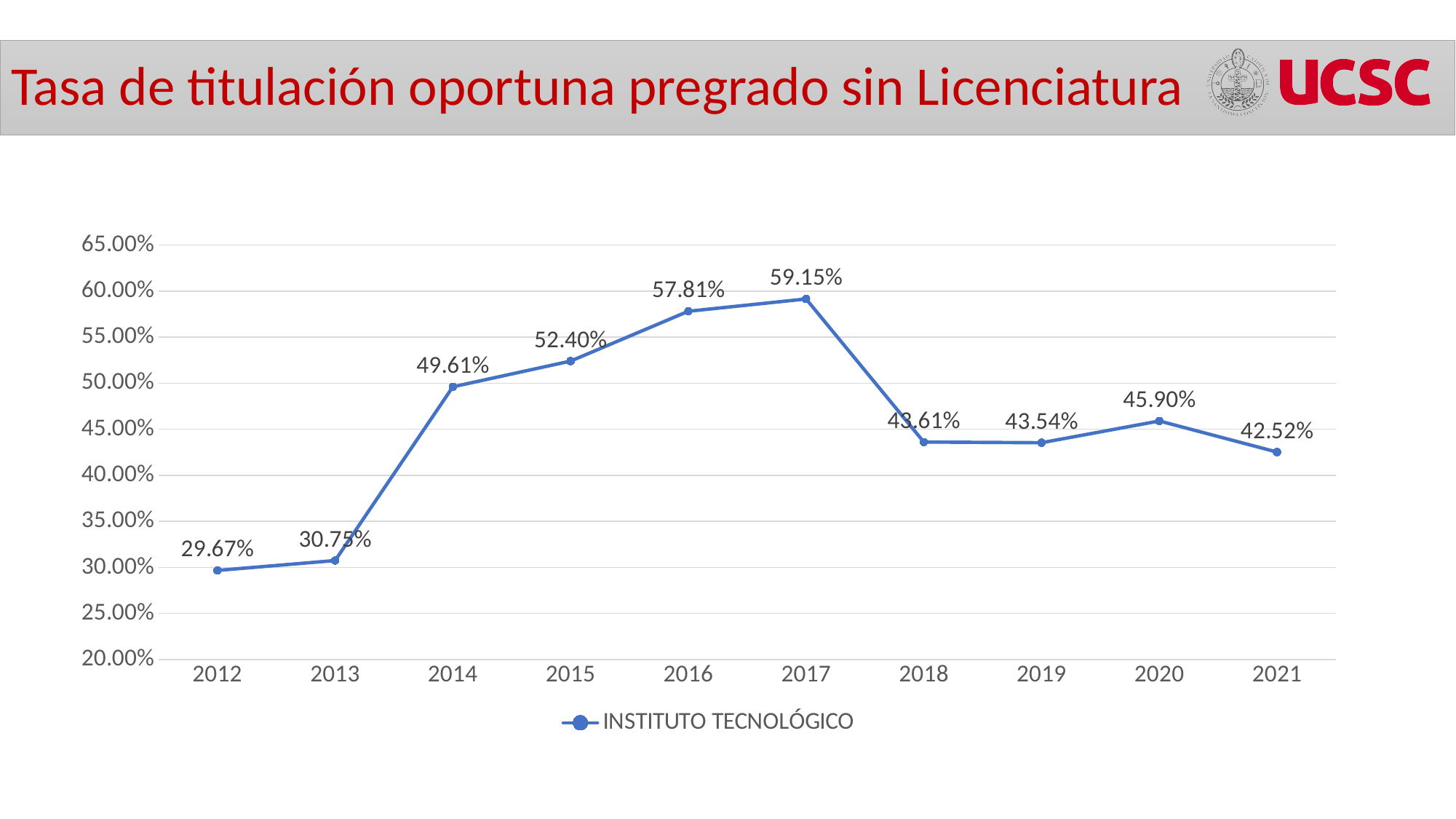
How many years are plotted on the x axis? 10 Is the value for 2016 greater or less than 55.00%? greater Which is larger, the value for 2015 or the value for 2018? 2015 What is the difference between the values for 2014 and 2013? 18.86% What is the value for 2012? 29.67% What is the difference between the values for 2017 and 2016? 1.34% What is the value for 2020? 45.90% What is the value for 2017? 59.15% What kind of chart is shown? line chart Which year has the highest value? 2017 Which year has the lowest value? 2012 What series name does the legend show? INSTITUTO TECNOLÓGICO